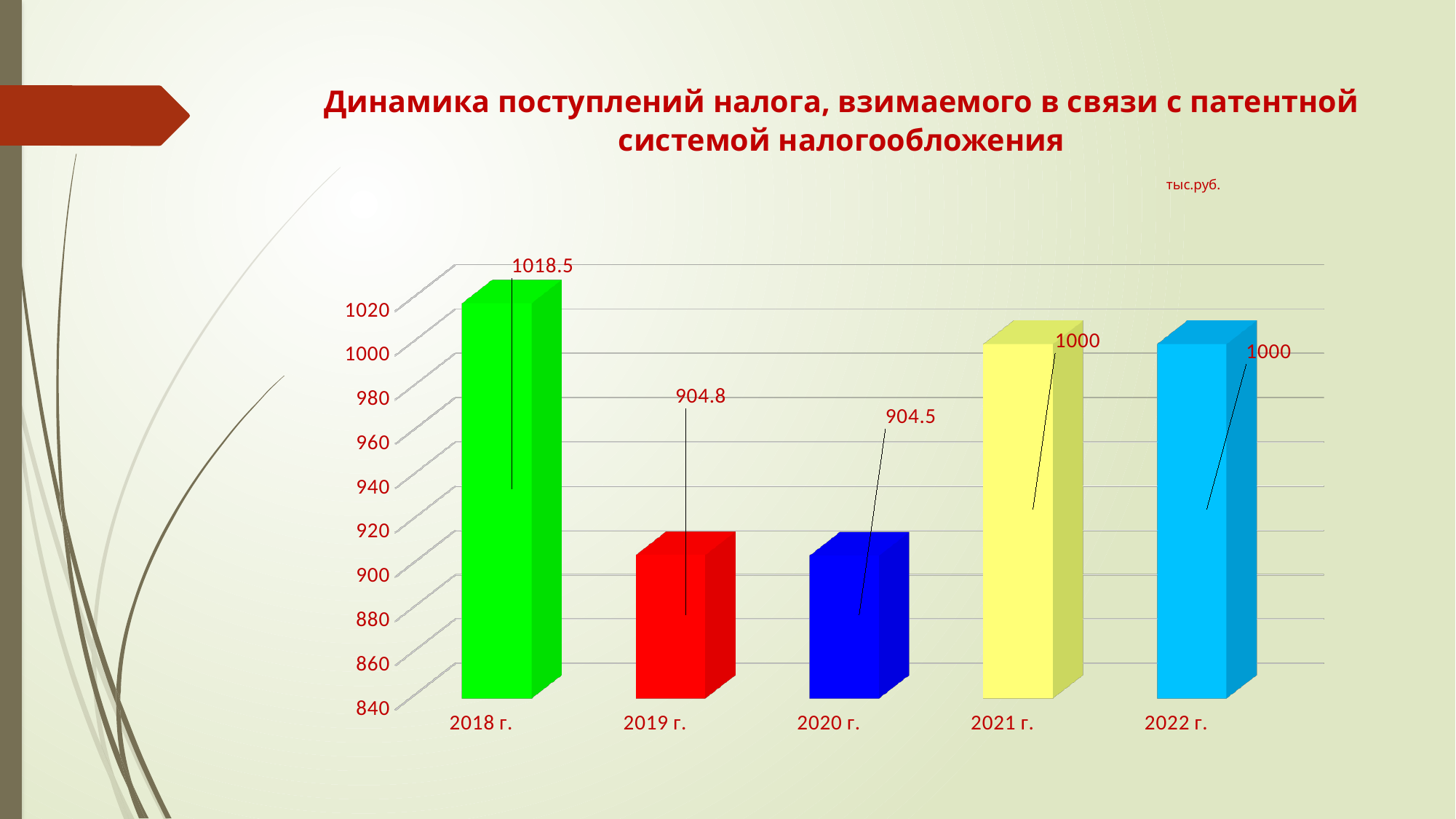
What is the value for 2022 г.? 1000 What is the difference between the values for 2018 г. and 2019 г.? 113.7 Is the value for 2019 г. greater or less than 900? greater What is the difference between the values for 2018 г. and 2021 г.? 18.5 Which year has the highest value? 2018 г. How many years are shown on the x axis? 5 What kind of chart is shown on the slide? bar chart Which is larger, the value for 2021 г. or the value for 2019 г.? 2021 г. What is the value for 2019 г.? 904.8 What is the value for 2020 г.? 904.5 What unit is indicated for the values on the chart? тыс.руб. What is the value for 2018 г.? 1018.5